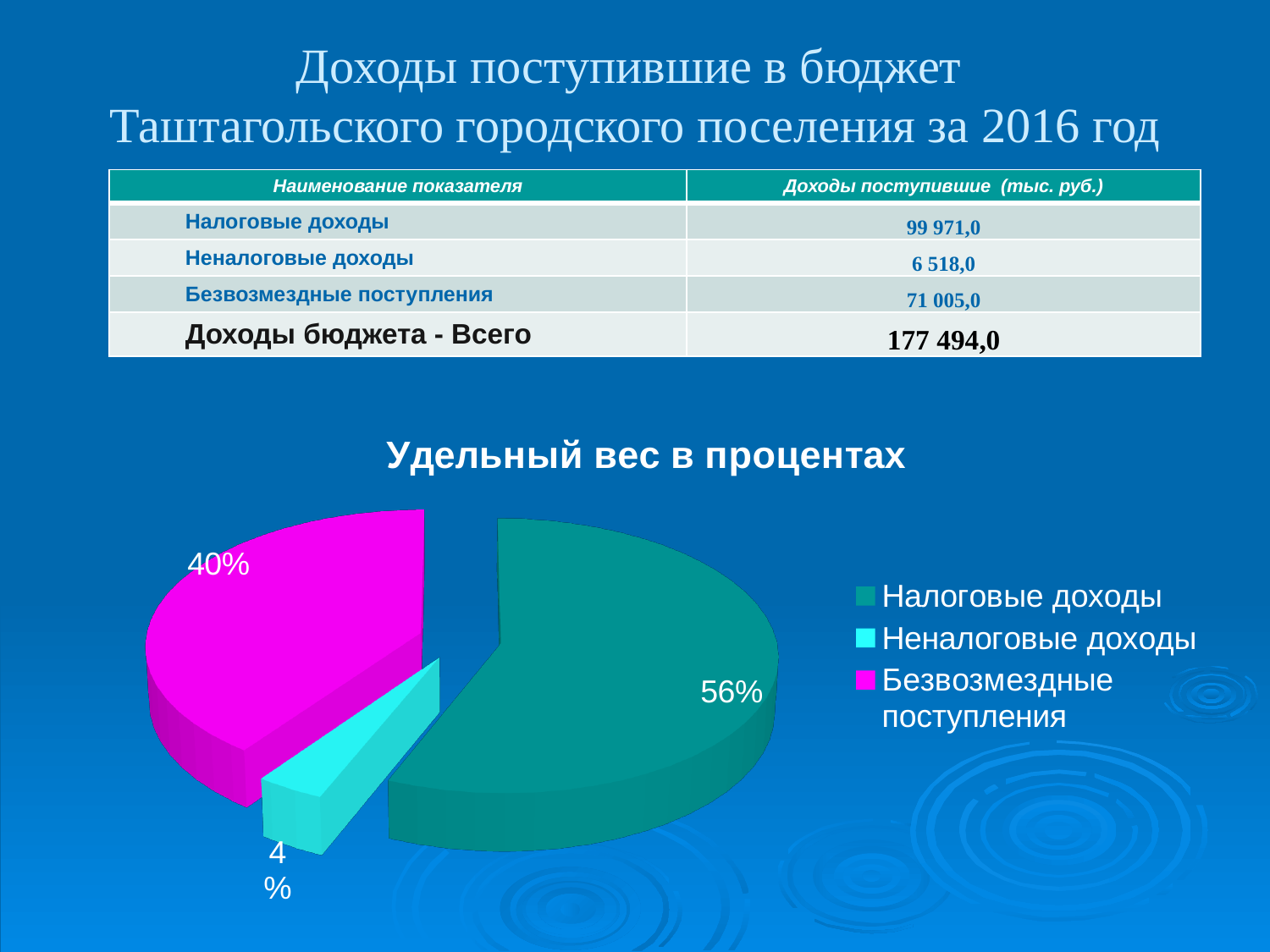
Which slice is larger: Безвозмездные поступления or Неналоговые доходы? Безвозмездные поступления What colour is the Безвозмездные поступления slice? magenta What share of the pie does Безвозмездные поступления have? 40% Which category has the smallest slice of the pie? Неналоговые доходы What share of the pie does Неналоговые доходы have? 4% Which category has the largest slice of the pie? Налоговые доходы What is the title of the chart? Удельный вес в процентах What is the difference in percentage points between the Налоговые доходы slice and the Безвозмездные поступления slice? 16 How many entries does the legend list? 3 What share of the pie does Налоговые доходы have? 56% What kind of chart is shown on the slide? pie chart How many slices does the pie chart have? 3